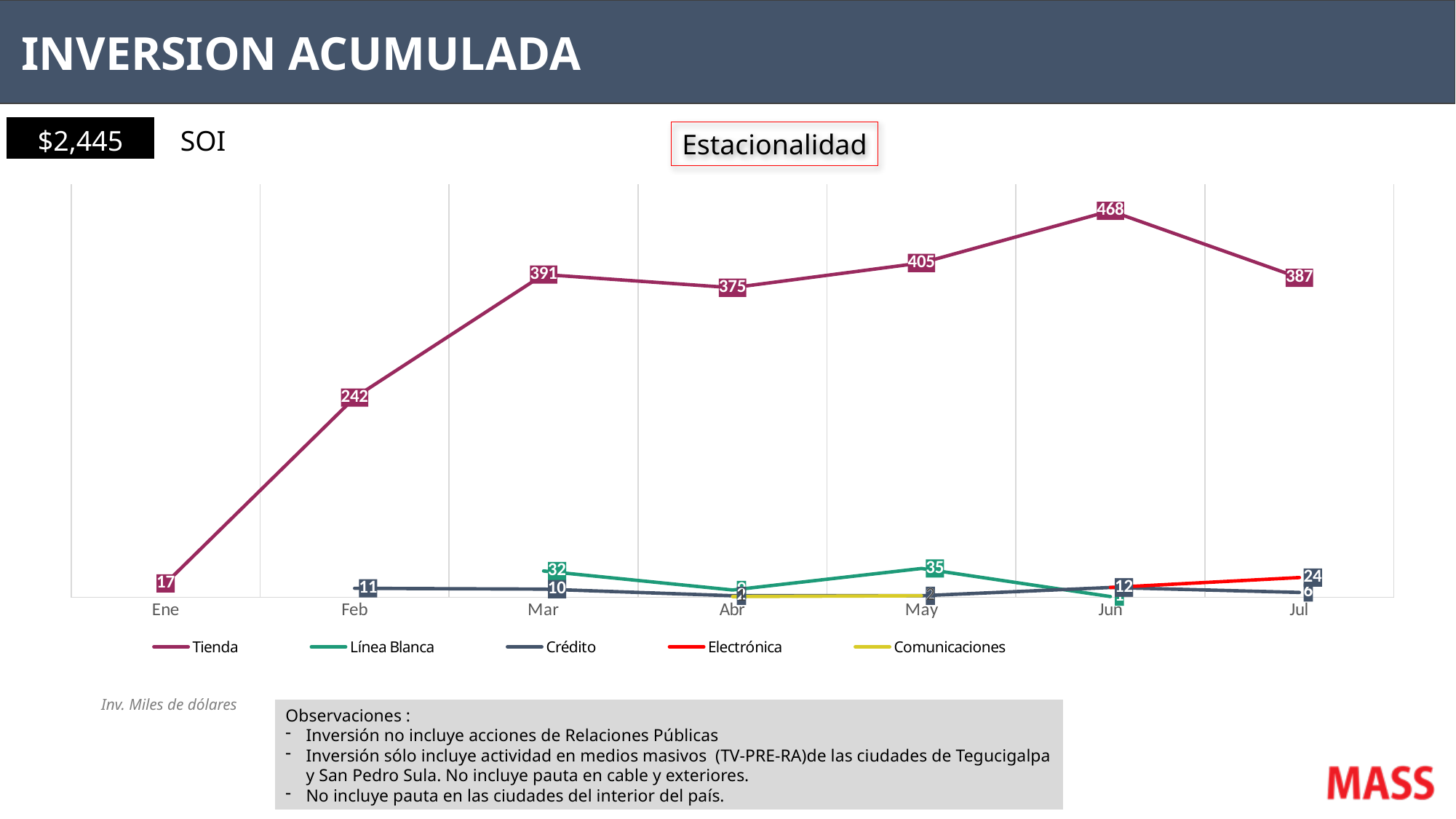
What is the value for Tienda in Ene? 17 In which month does Tienda reach its highest value? Jun Does the Tienda line rise or fall from Ene to Mar? Rise How many series does the legend list? 5 What is the value for Tienda in Jun? 468 How many months are shown on the x axis? 7 Which is larger for Tienda: the value in Mar or the value in Abr? Mar What is the value for Electrónica in Jul? 24 What kind of chart is shown on the slide? Line chart What is the value for Línea Blanca in May? 35 In which month does Tienda have its lowest value? Ene What is the difference between the Tienda values for Jun and Jul? 81